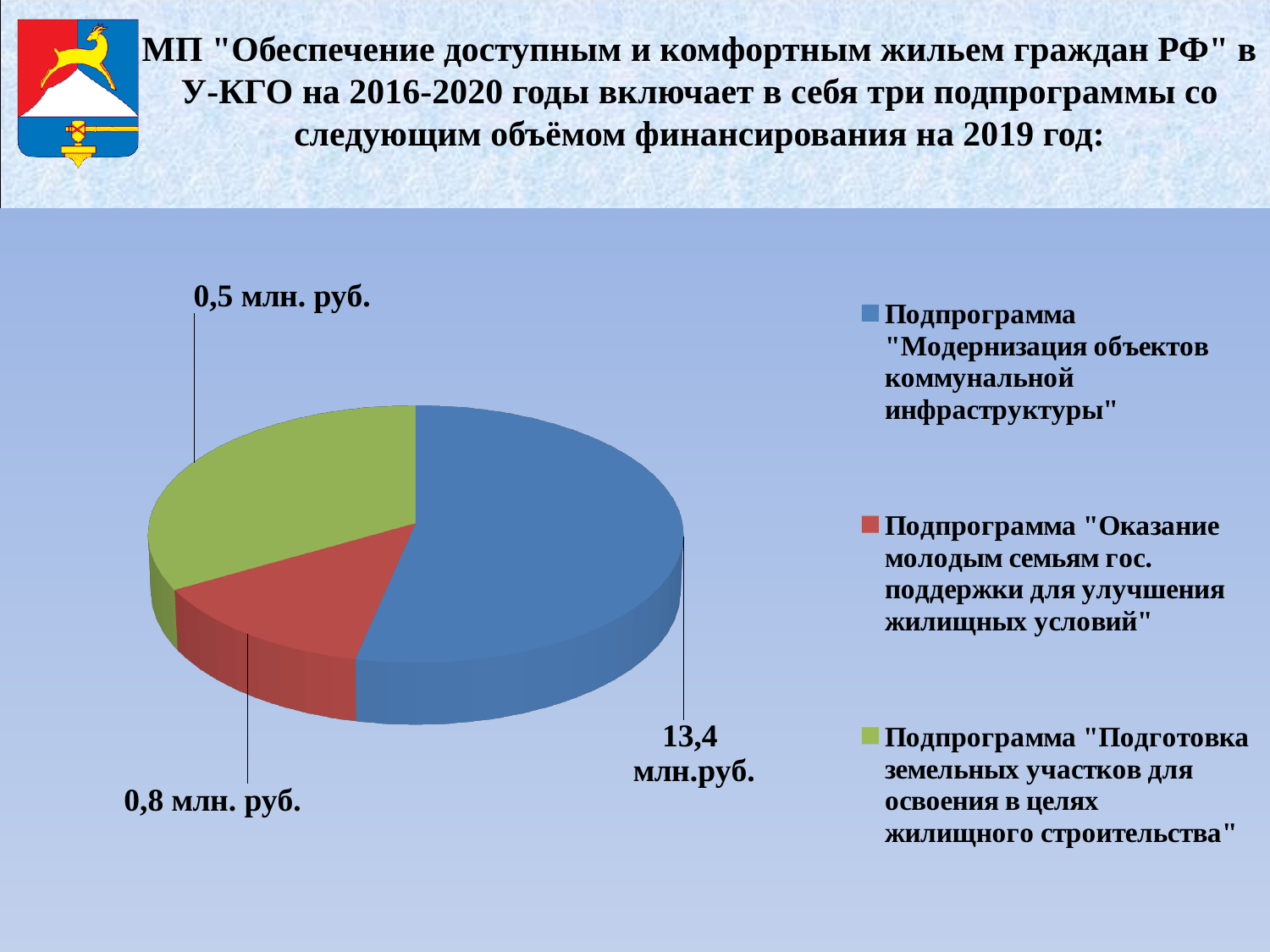
Which subprogram has the smallest funding amount in the pie chart? Подпрограмма "Подготовка земельных участков для освоения в целях жилищного строительства" What is the difference between the funding for "Модернизация объектов коммунальной инфраструктуры" and "Оказание молодым семьям гос. поддержки для улучшения жилищных условий"? 12,6 млн. руб. What is the total funding of the three subprograms shown in the pie chart? 14,7 млн. руб. What type of chart is shown on the slide? Pie chart How many slices does the pie chart have? 3 Which has more funding: the subprogram "Оказание молодым семьям гос. поддержки для улучшения жилищных условий" or the subprogram "Подготовка земельных участков для освоения в целях жилищного строительства"? Подпрограмма "Оказание молодым семьям гос. поддержки для улучшения жилищных условий" What colour is the slice for the subprogram "Оказание молодым семьям гос. поддержки для улучшения жилищных условий"? Red How many entries does the legend of the pie chart list? 3 What is the funding amount for the subprogram "Оказание молодым семьям гос. поддержки для улучшения жилищных условий"? 0,8 млн. руб. What is the funding amount for the subprogram "Модернизация объектов коммунальной инфраструктуры"? 13,4 млн.руб. Which subprogram has the largest funding amount in the pie chart? Подпрограмма "Модернизация объектов коммунальной инфраструктуры" What is the funding amount for the subprogram "Подготовка земельных участков для освоения в целях жилищного строительства"? 0,5 млн. руб.